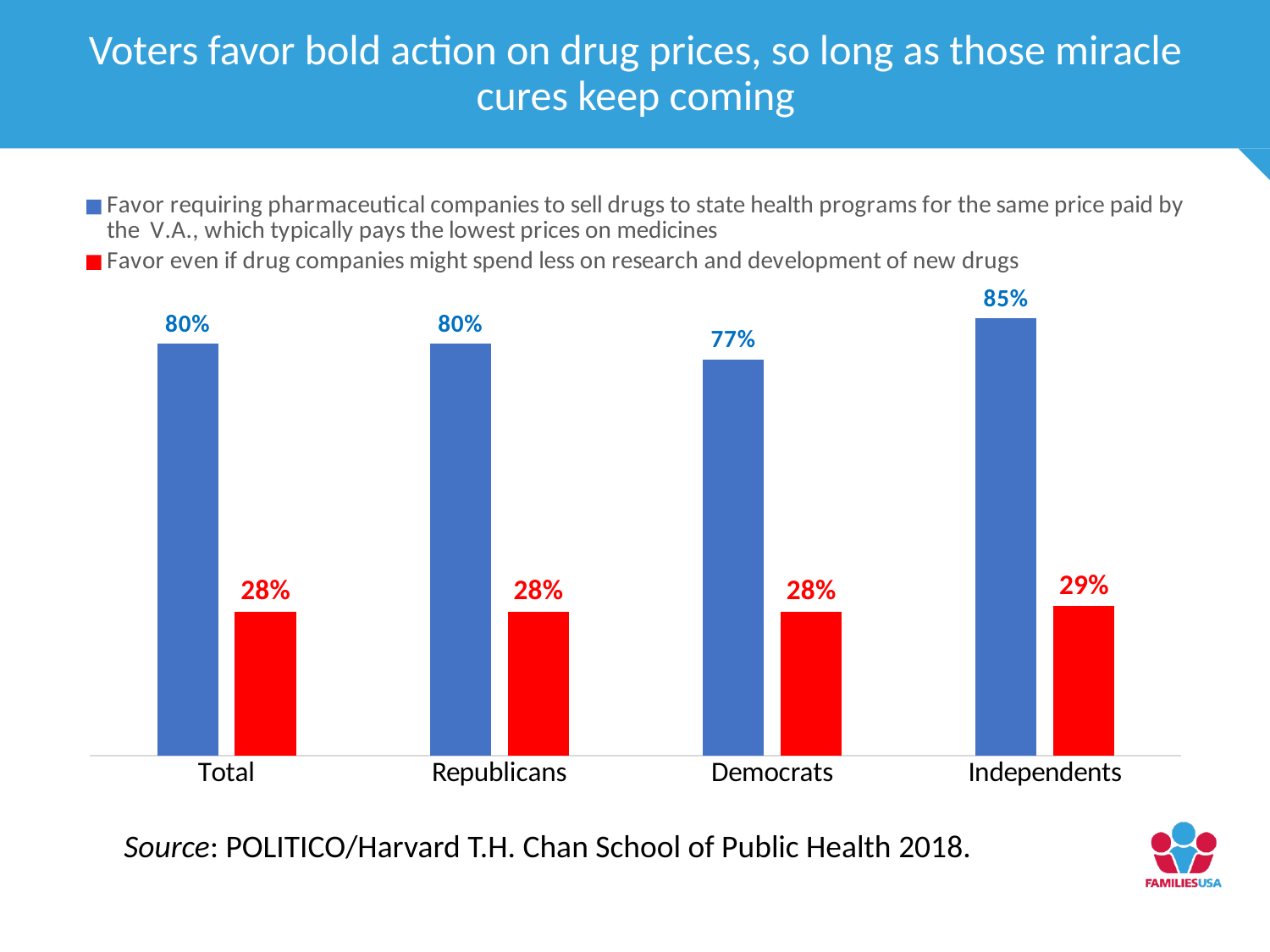
How many series does the legend list? 2 What colour are the bars for the series 'Favor even if drug companies might spend less on research and development of new drugs'? Red How much higher is the Independents' blue bar than the Democrats' blue bar? 8 percentage points Which group has the highest share favoring requiring V.A. pricing for state health programs? Independents Which is larger: the red bar for Independents or the red bar for Republicans? Independents What is the difference between the blue and red bars for the Total group? 52 percentage points What percentage of Democrats favor the policy even if drug companies might spend less on research and development? 28% What kind of chart is shown on the slide? Bar chart What percentage of Independents favor requiring pharmaceutical companies to sell drugs to state health programs at the V.A. price? 85% Which group has the lowest share favoring requiring V.A. pricing for state health programs? Democrats How many groups are shown on the x axis? 4 What is the value for Republicans in the blue series (favor requiring V.A. pricing)? 80%